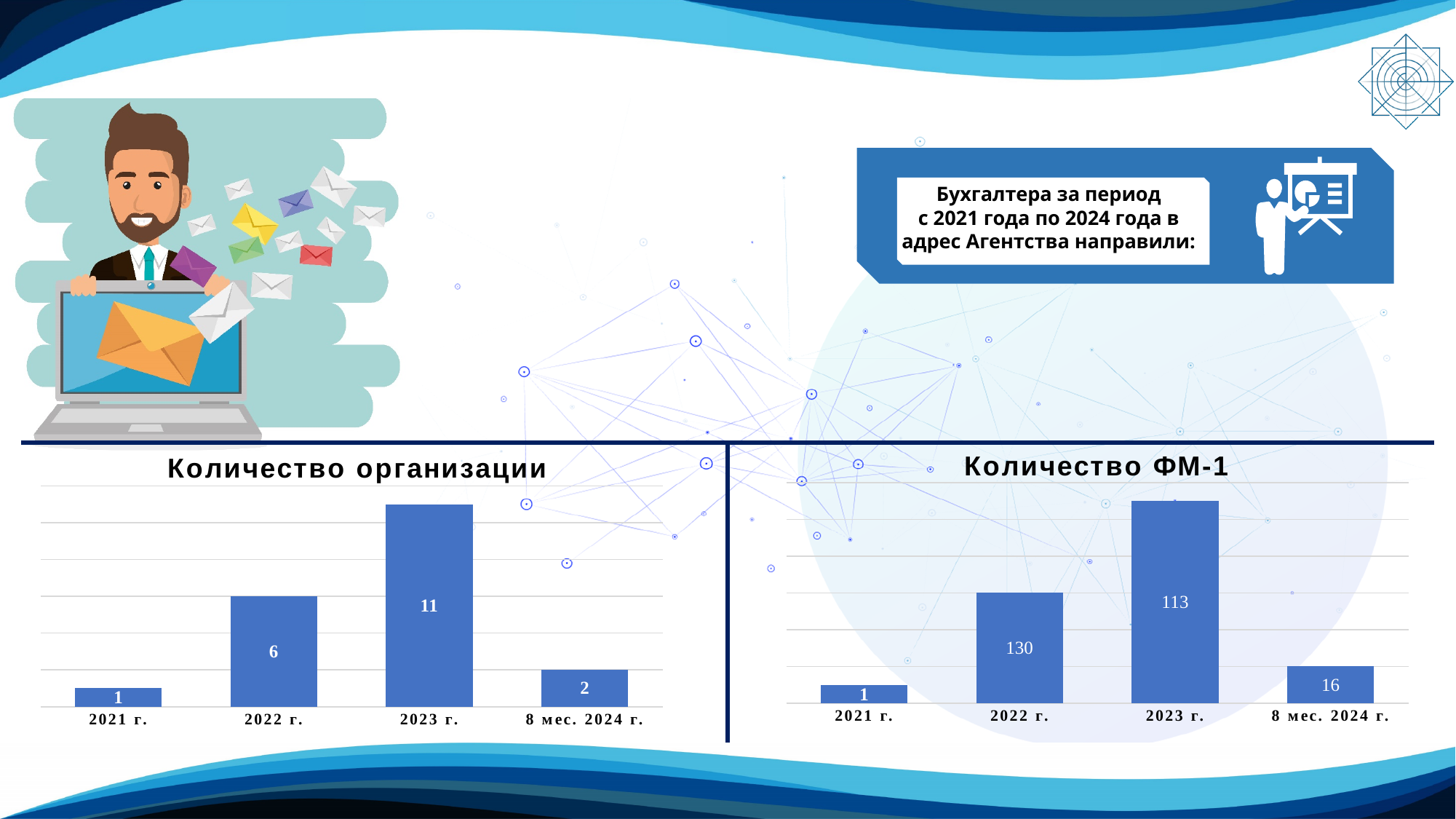
In the chart titled "Количество ФМ-1", which category has the lowest value? 2021 г. What type of chart is the chart titled "Количество ФМ-1"? Bar chart In the chart titled "Количество организации", what is the value for 2023 г.? 11 In the chart titled "Количество ФМ-1", what is the value for 8 мес. 2024 г.? 16 In the chart titled "Количество ФМ-1", what is the difference between the values for 2022 г. and 8 мес. 2024 г.? 114 In the chart titled "Количество организации", which category has the lowest value? 2021 г. In the chart titled "Количество организации", what is the difference between the values for 2023 г. and 2022 г.? 5 In the chart titled "Количество организации", how many categories are shown on the x axis? 4 In the chart titled "Количество ФМ-1", what is the value for 2022 г.? 130 In the chart titled "Количество организации", which category has the highest value? 2023 г. In the chart titled "Количество ФМ-1", which is larger, the value for 2022 г. or the value for 2021 г.? 2022 г. In the chart titled "Количество организации", what is the value for 8 мес. 2024 г.? 2